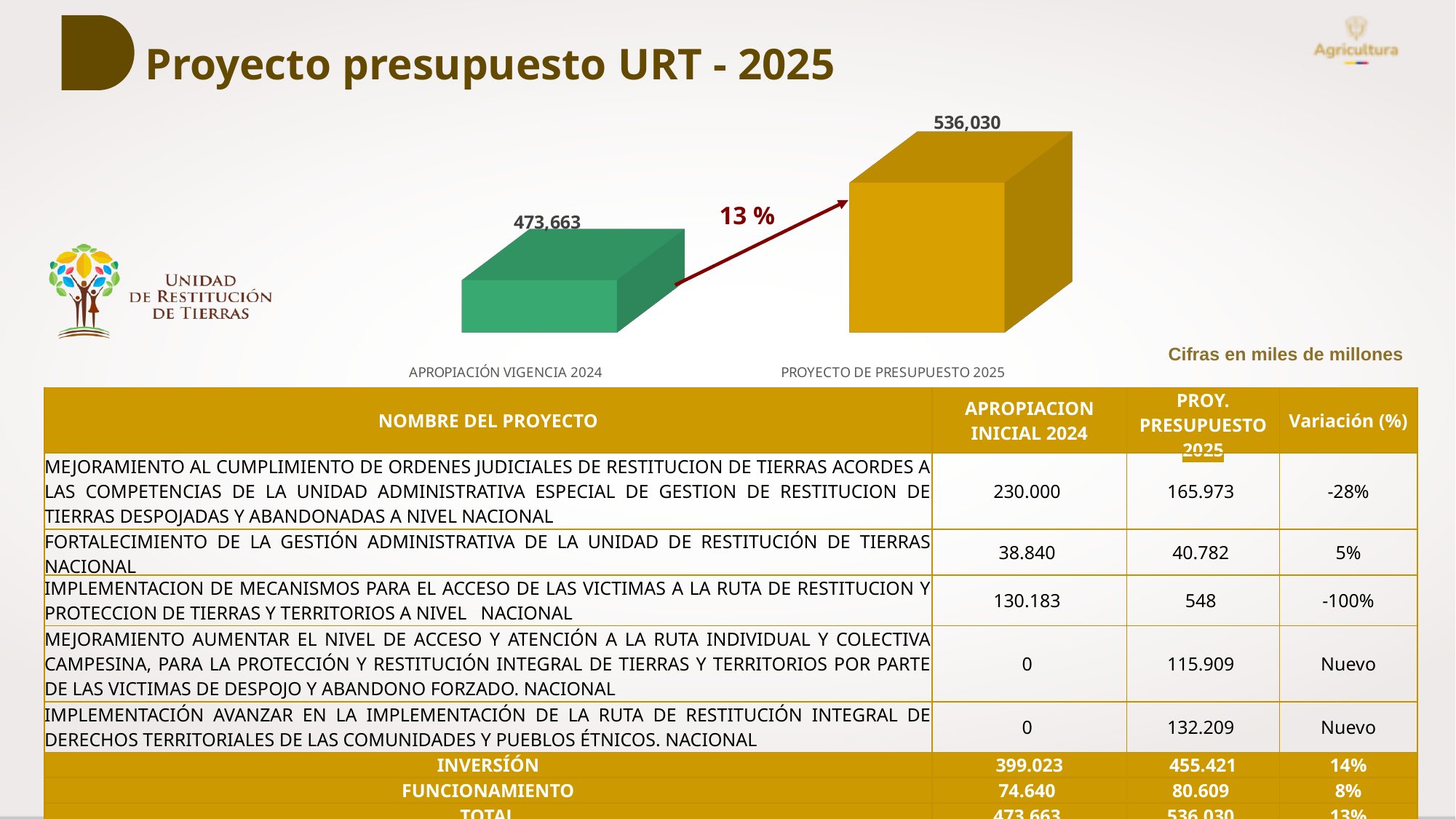
What is the value shown for PROYECTO DE PRESUPUESTO 2025 in the chart? 536,030 Which category in the chart has the lower value? APROPIACIÓN VIGENCIA 2024 Which category in the chart has the higher value? PROYECTO DE PRESUPUESTO 2025 Is the value for PROYECTO DE PRESUPUESTO 2025 larger or smaller than the value for APROPIACIÓN VIGENCIA 2024? larger Do the values in the chart rise or fall from 2024 to 2025? rise What kind of chart is shown on the slide? bar chart What unit note is shown next to the chart for the figures? Cifras en miles de millones What percentage change is labelled on the arrow between the two bars in the chart? 13 % What is the difference between the 2025 projected budget and the 2024 appropriation in the chart? 62,367 What is the value shown for APROPIACIÓN VIGENCIA 2024 in the chart? 473,663 How many bars are plotted in the chart? 2